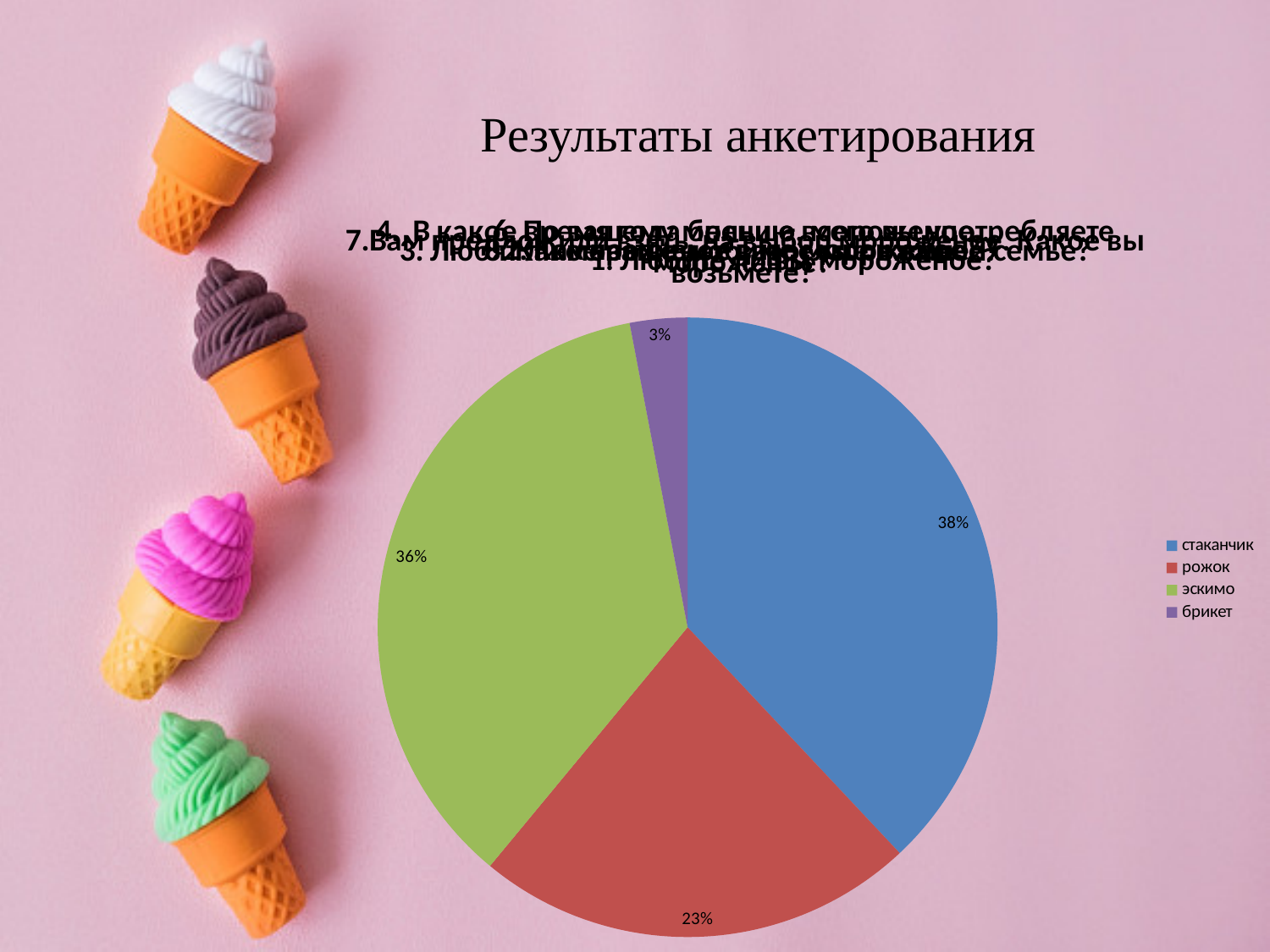
What share of the pie does брикет have? 3% Which category has the smallest slice of the pie? брикет What kind of chart is shown on the slide? pie chart Which category has the largest slice of the pie? стаканчик What colour is the slice for эскимо? green Which category is listed first in the legend? стаканчик What share of the pie does эскимо have? 36% What share of the pie does рожок have? 23% What share of the pie does стаканчик have? 38% Which is larger, the share for эскимо or the share for рожок? эскимо How many categories does the pie chart show? 4 What is the difference in percentage points between стаканчик and рожок? 15